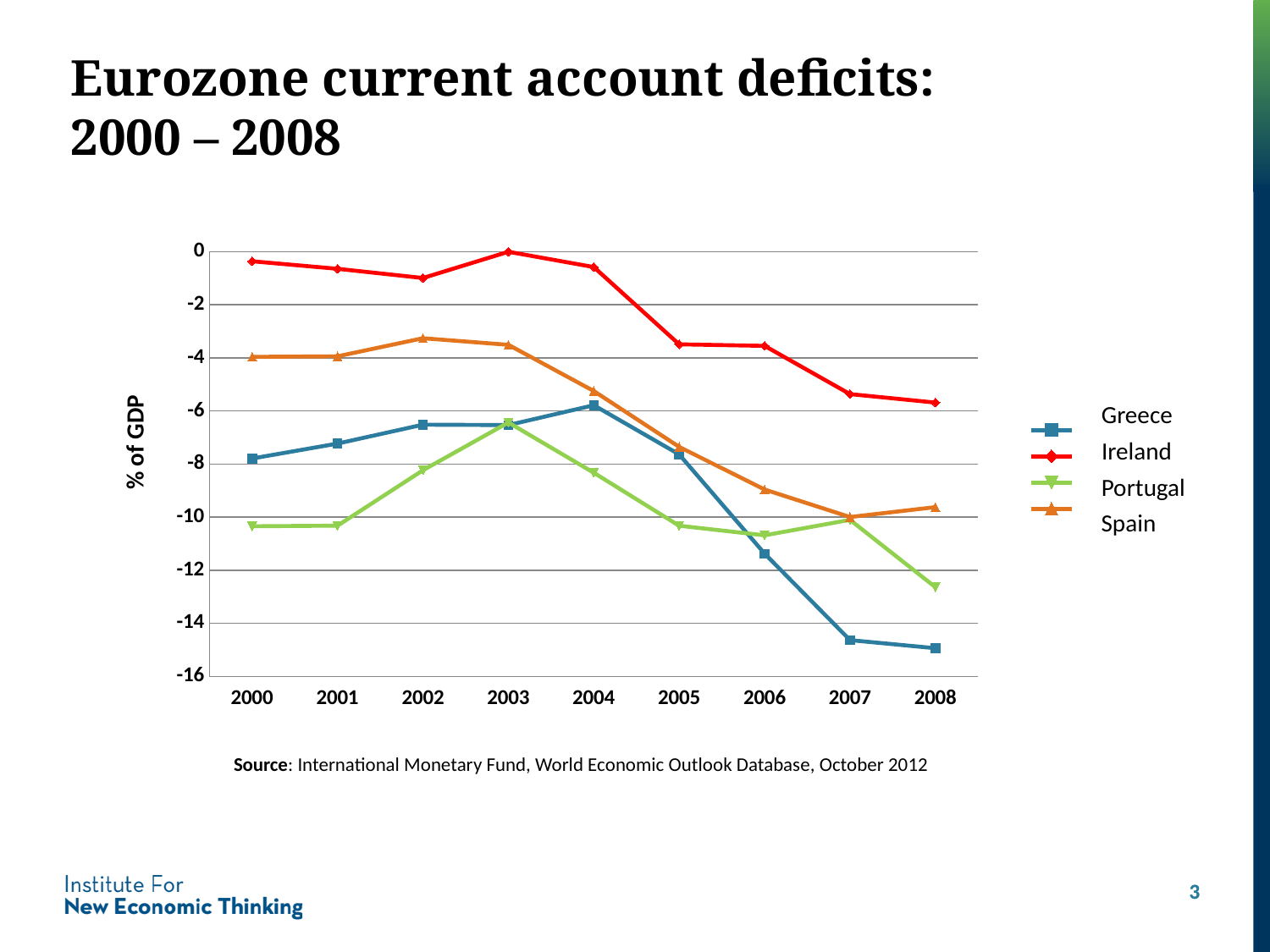
Which country has the lowest value in 2008? Greece Which country has the lowest value in 2000? Portugal Is the value for Portugal in 2008 greater or less than -12? less Is the value for Greece in 2008 greater or less than -14? less What kind of chart is shown on the slide? Line chart Which country has the highest value in 2008? Ireland Is the value for Ireland in 2000 greater or less than -2? greater How many years are plotted along the x axis? 9 Which is larger in 2008, the value for Spain or the value for Greece? Spain Does the Greece line rise or fall from 2004 to 2008? Fall How many series does the legend list? 4